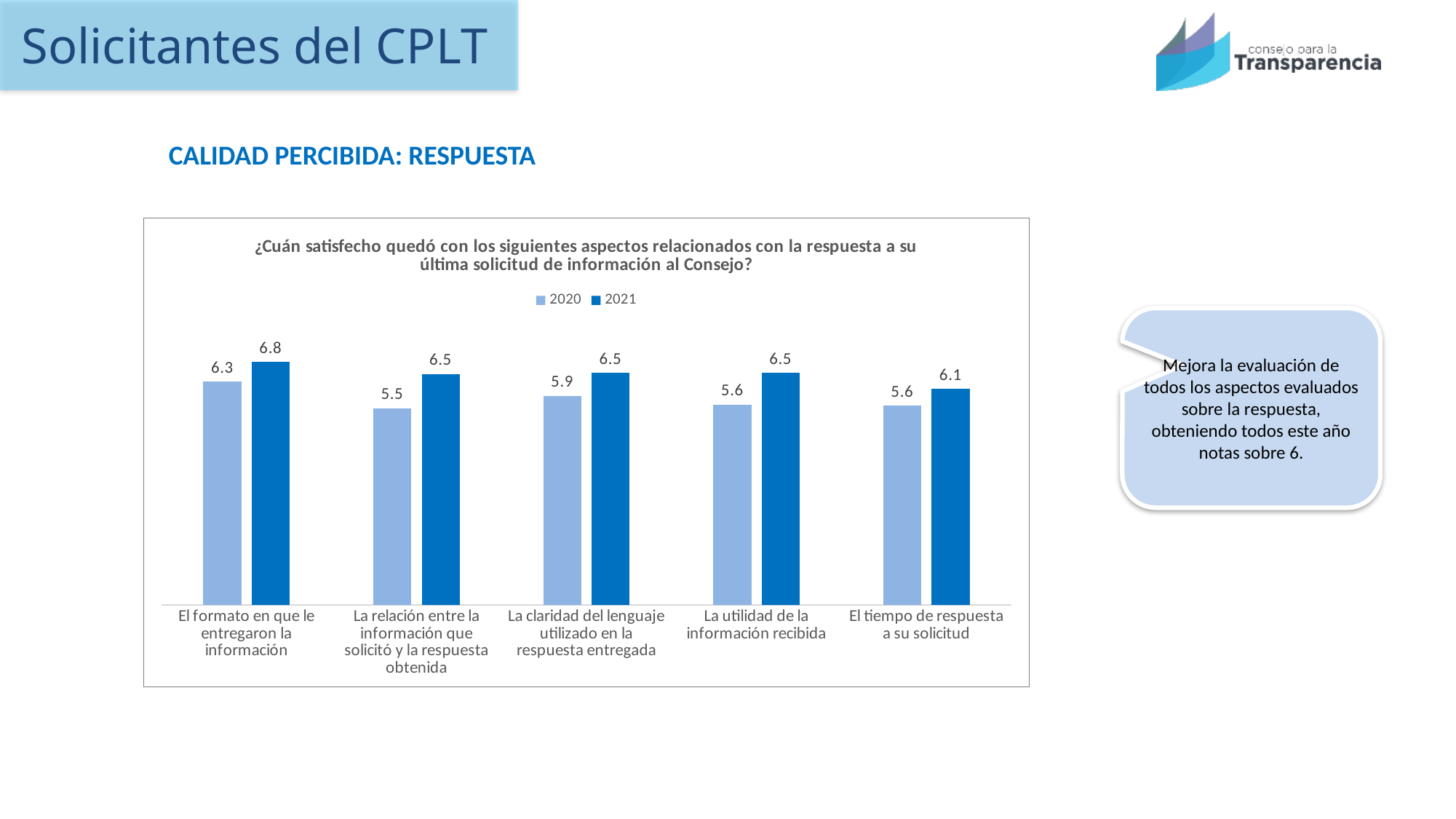
How many categories are shown on the x axis? 5 What is the 2020 value for 'La claridad del lenguaje utilizado en la respuesta entregada'? 5.9 Which category has the lowest 2020 value? La relación entre la información que solicitó y la respuesta obtenida What is the difference between the 2021 and 2020 values for 'La relación entre la información que solicitó y la respuesta obtenida'? 1.0 What is the 2021 value for 'El tiempo de respuesta a su solicitud'? 6.1 Which is larger for 'La utilidad de la información recibida': the 2020 value or the 2021 value? 2021 What is the 2021 value for 'El formato en que le entregaron la información'? 6.8 What kind of chart is shown? Bar chart Which category has the highest 2021 value? El formato en que le entregaron la información Which series is shown in the darker blue colour? 2021 How many series does the legend list? 2 What is the difference between the 2021 value for 'El formato en que le entregaron la información' and the 2021 value for 'El tiempo de respuesta a su solicitud'? 0.7